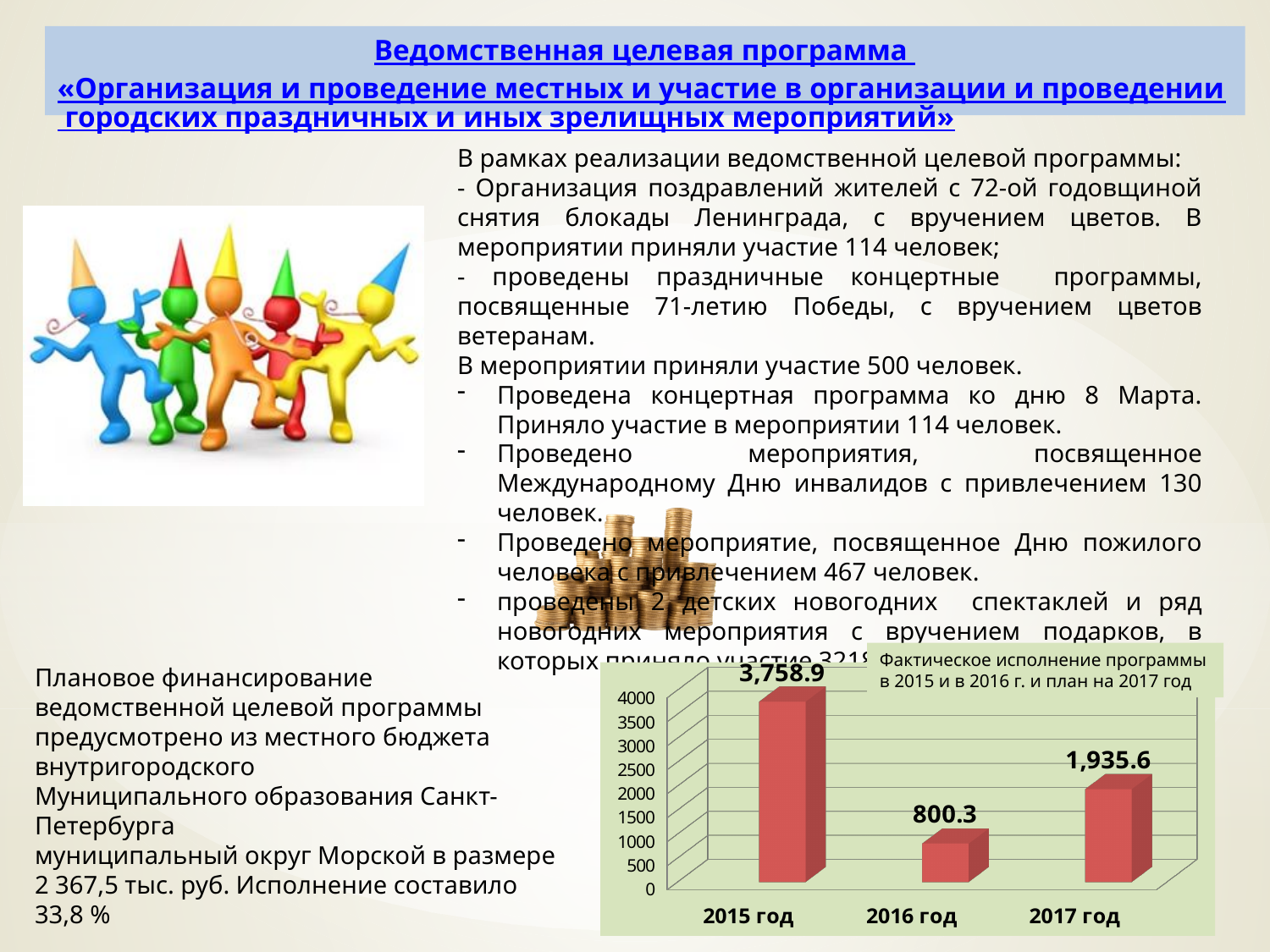
Which year has the lowest value in the chart? 2016 год What is the difference between the values for 2017 год and 2016 год? 1,135.3 Is the value for 2016 год greater or less than 1000? less What is the value shown for 2017 год? 1,935.6 What kind of chart is shown on the slide? bar chart Which is larger, the value for 2017 год or the value for 2016 год? 2017 год What is the title of the chart? Фактическое исполнение программы в 2015 и в 2016 г. и план на 2017 год What is the value shown for 2015 год? 3,758.9 What is the difference between the values for 2015 год and 2016 год? 2,958.6 What is the value shown for 2016 год? 800.3 Which year has the highest value in the chart? 2015 год How many years (categories) are shown in the chart? 3